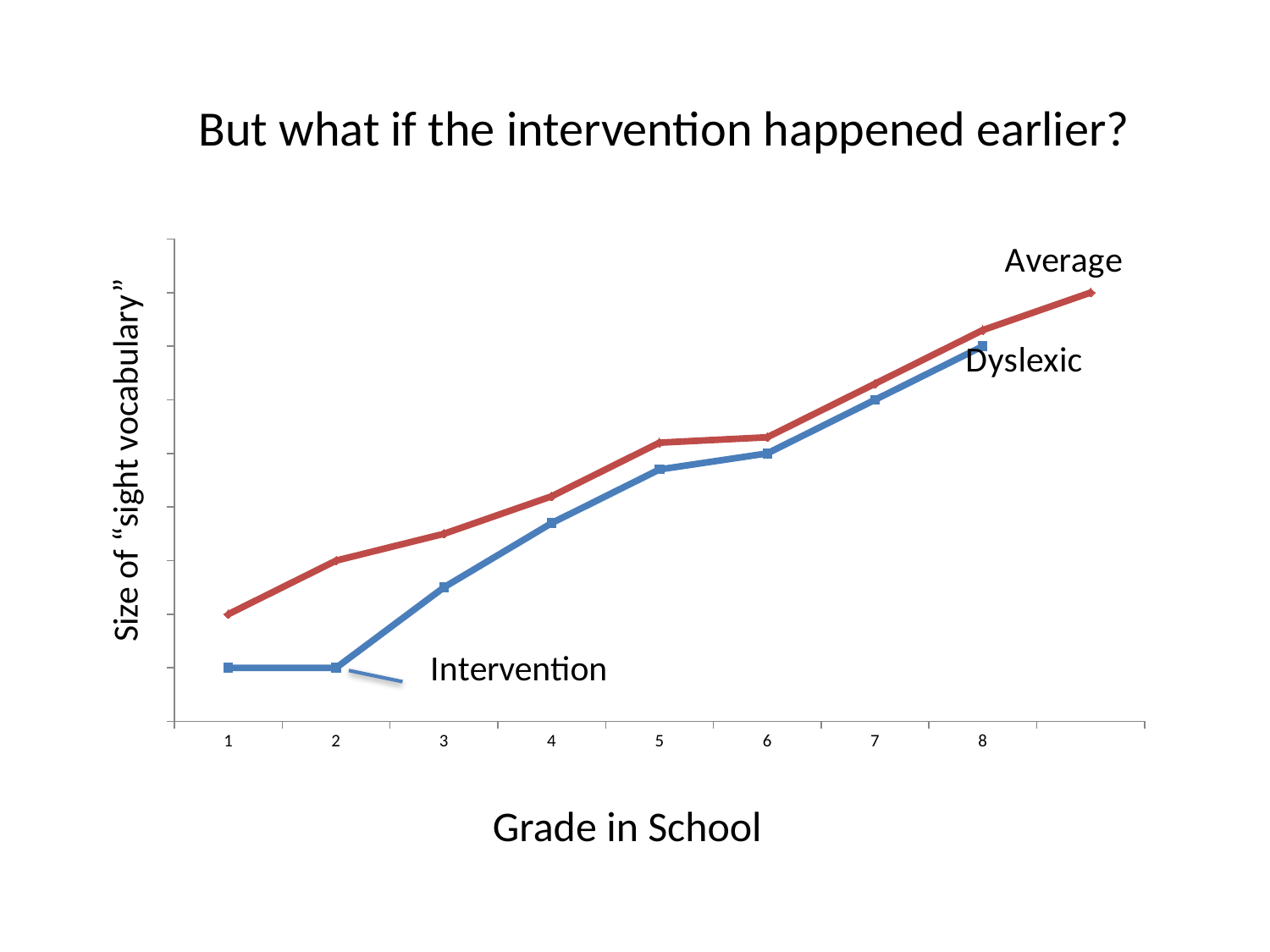
How many grade labels are shown on the x axis? 8 Does the Dyslexic series rise or stay flat between grade 1 and grade 2? stay flat Does the Average series rise or fall as grade in school increases? rise What kind of chart is shown on the slide? line chart What is the title of the slide above the chart? But what if the intervention happened earlier? Does the Dyslexic series rise or fall between grade 2 and grade 8? rise At grade 8, which series has the higher value, Average or Dyslexic? Average What are the names of the two series plotted on the chart? Average and Dyslexic Which series is plotted in red? Average At grade 3, which series has the higher value, Average or Dyslexic? Average At grade 1, which series has the lower value, Average or Dyslexic? Dyslexic How many series are plotted on the chart? 2